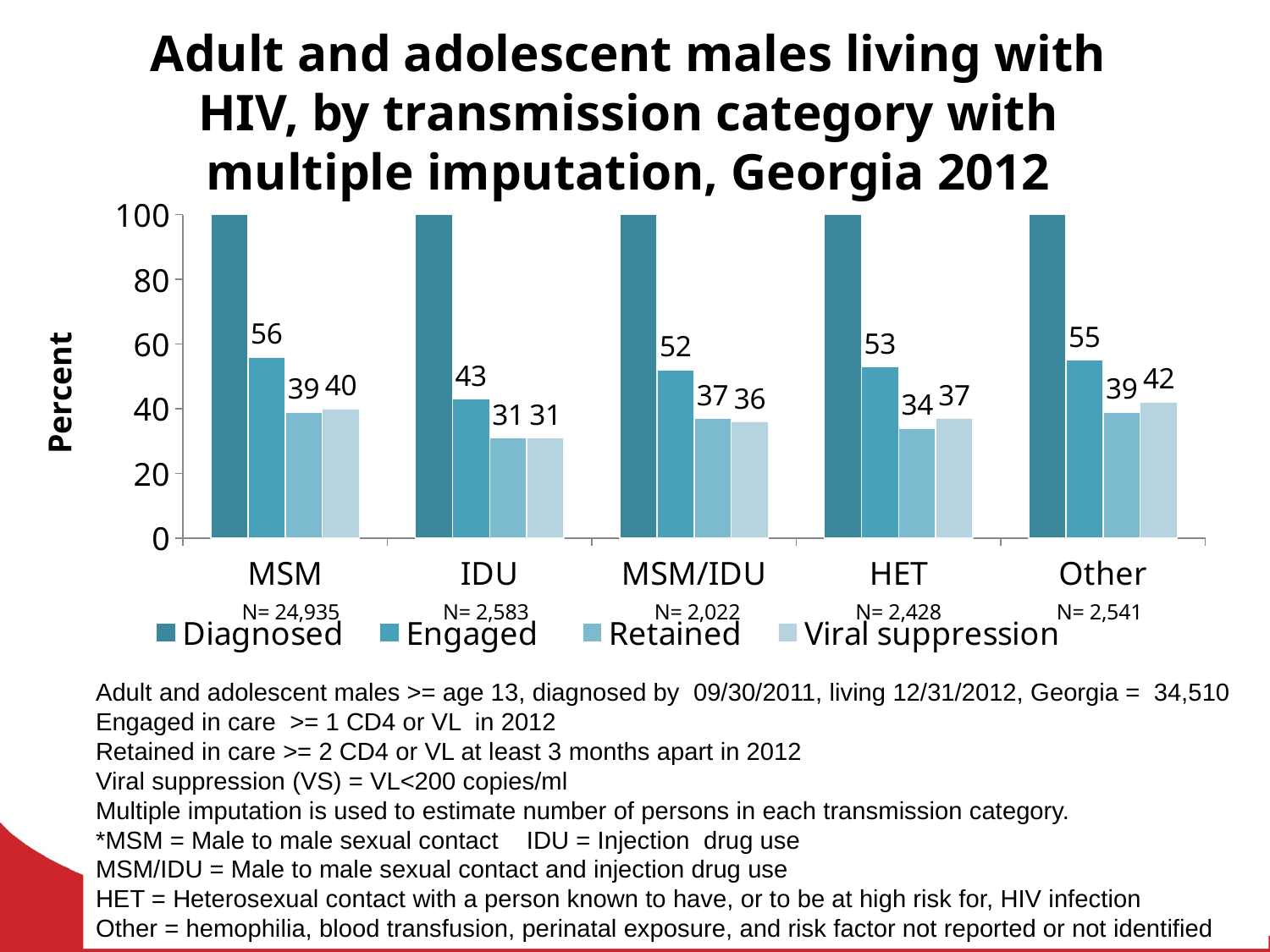
Is the Diagnosed value for IDU greater or less than 80? greater What kind of chart is shown on the slide? bar chart Which transmission category has the lowest Engaged value? IDU What is the Viral suppression value for Other? 42 What is the Engaged value for MSM? 56 Which transmission category has the highest Engaged value? MSM What is the label on the y axis? Percent How many series does the legend list? 4 What is the Retained value for HET? 34 What is the difference between the Engaged value for MSM and the Engaged value for IDU? 13 How many transmission categories are shown on the x axis? 5 Which is larger, the Viral suppression value for HET or the Viral suppression value for Other? Other